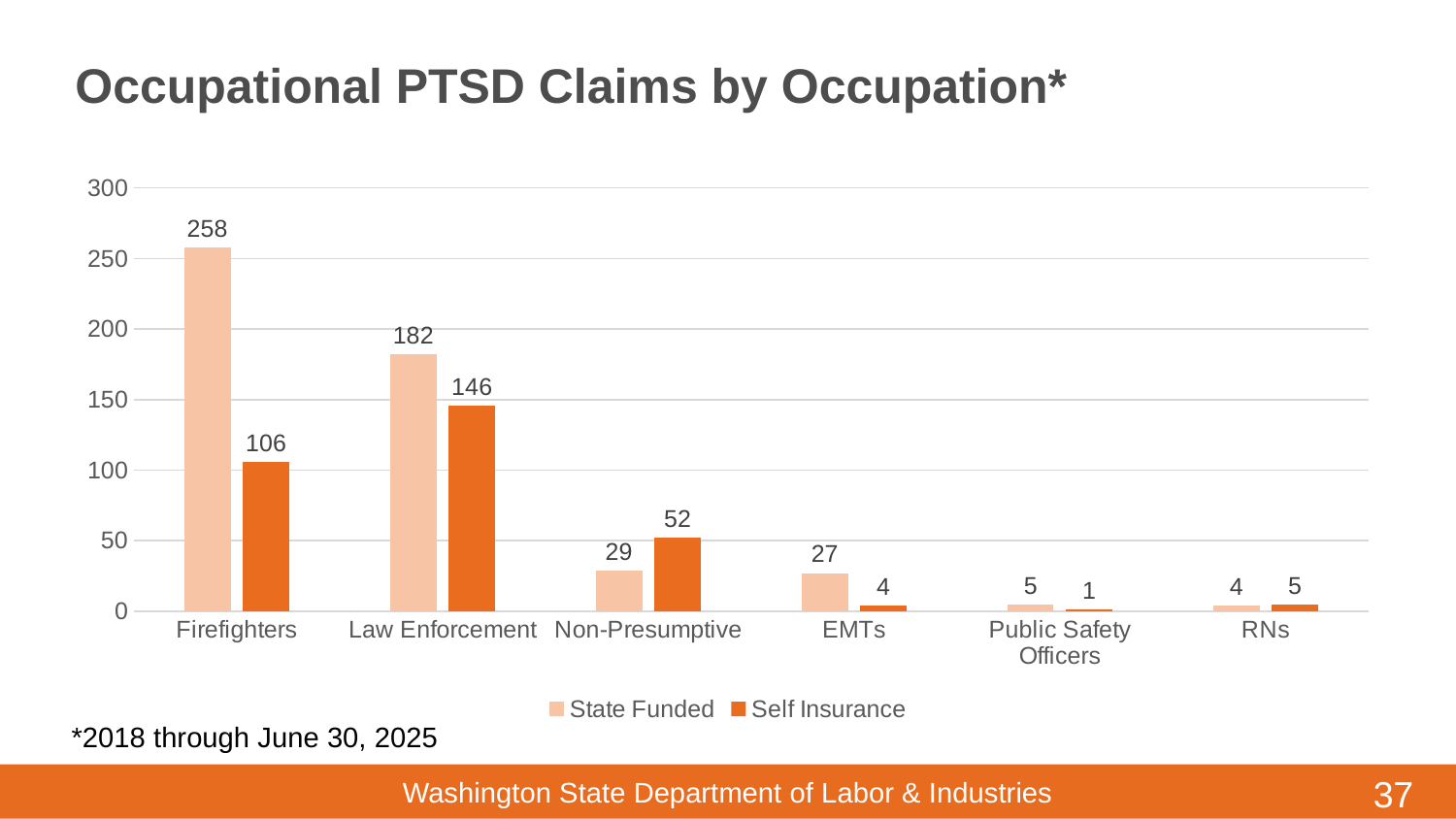
Which occupation has the highest State Funded value? Firefighters How many occupation categories are shown on the x axis? 6 What is the State Funded value for Firefighters? 258 What is the Self Insurance value for Law Enforcement? 146 Which occupation has the lowest Self Insurance value? Public Safety Officers What is the title of the chart? Occupational PTSD Claims by Occupation* What is the difference between the State Funded and Self Insurance values for Firefighters? 152 What kind of chart is shown on the slide? Bar chart What is the Self Insurance value for Non-Presumptive? 52 Which is larger for Non-Presumptive, the State Funded value or the Self Insurance value? Self Insurance How many series does the legend list? 2 What is the State Funded value for EMTs? 27